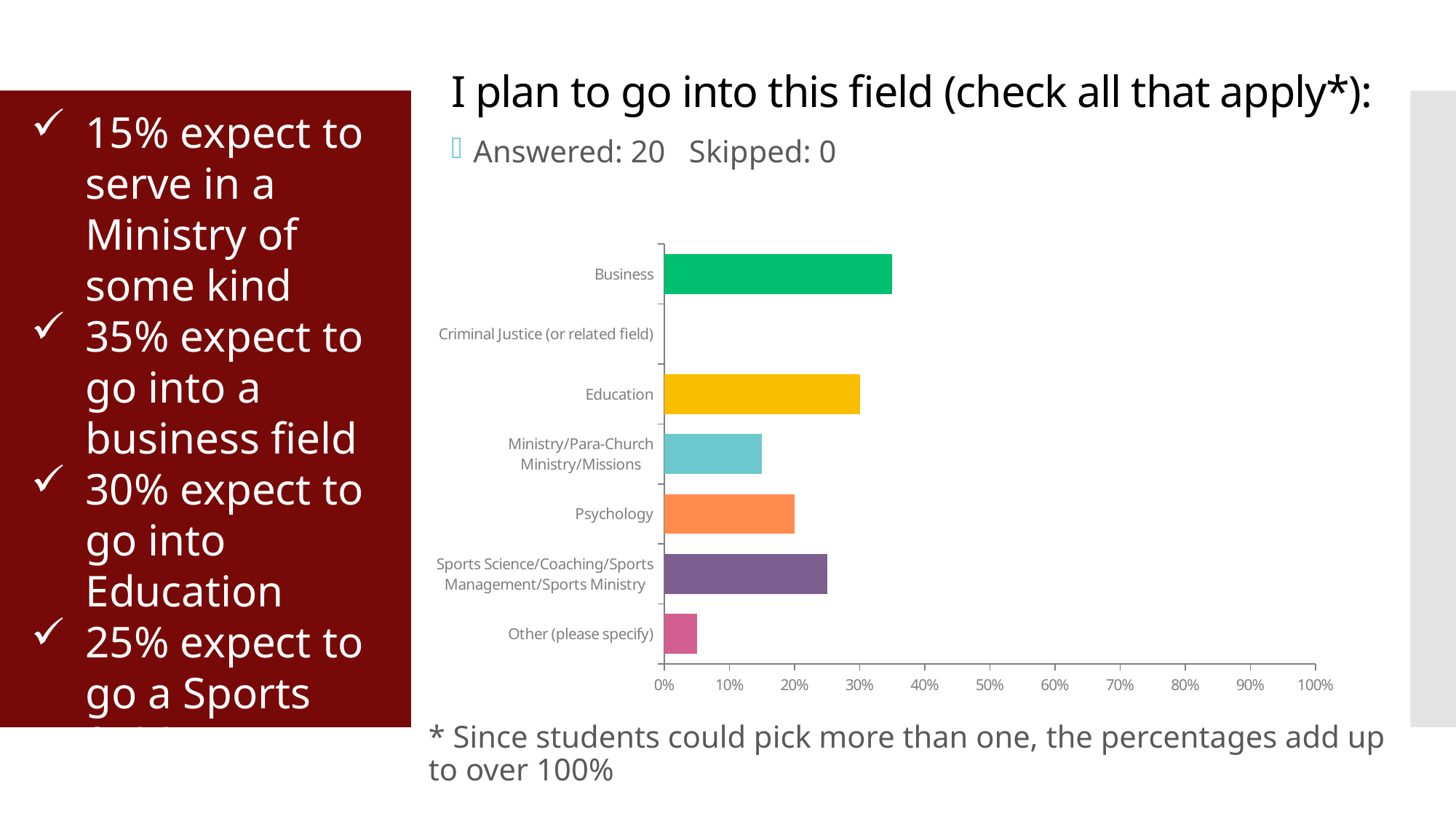
How many categories (fields) are listed on the chart? 7 What percentage of students plan to go into Psychology? 20% What percentage of students plan to go into Ministry/Para-Church Ministry/Missions? 15% Which field has the lowest percentage on the chart? Criminal Justice (or related field) How many respondents answered the survey question shown on the chart? 20 Which is larger, the value for Education or the value for Psychology? Education What is the difference between the percentage for Business and the percentage for Education? 5% Which field has the highest percentage on the chart? Business Is the value for Other (please specify) greater or less than 10%? less What percentage of students plan to go into Business? 35% What type of chart is shown on the slide? bar chart What percentage of students plan to go into Education? 30%